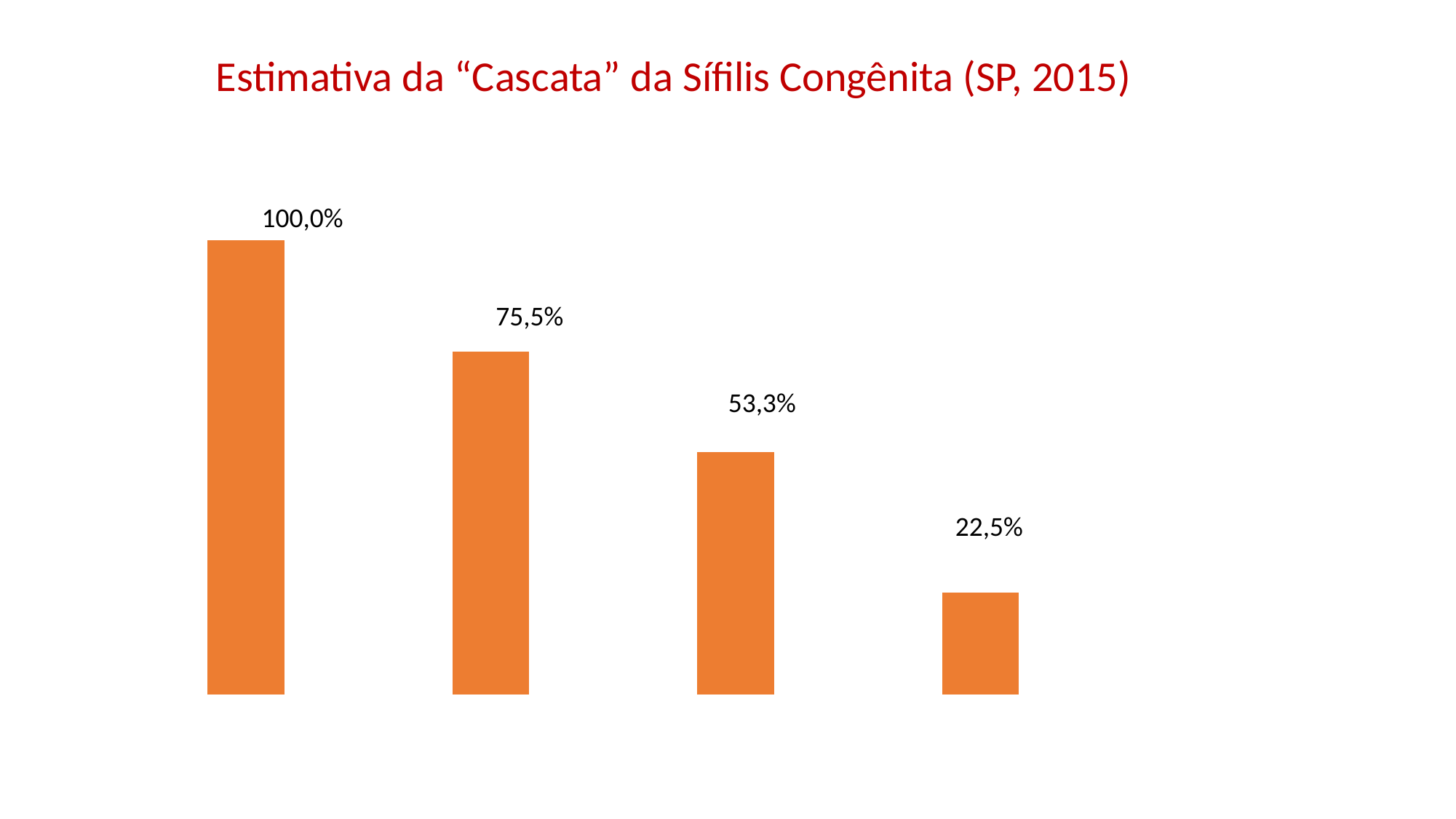
How many bars are plotted in the chart? 4 Which bar has the lowest value? The fourth (rightmost) bar, 22,5% What is the value shown on the first (leftmost) bar? 100,0% What is the value shown on the third bar from the left? 53,3% Do the bar values rise or fall from left to right? Fall What is the value shown on the second bar from the left? 75,5% Which is larger, the second bar or the third bar? The second bar (75,5%) What type of chart is shown on the slide? Bar chart What is the value shown on the fourth (rightmost) bar? 22,5% What is the difference between the first bar (100,0%) and the second bar (75,5%)? 24,5% What is the difference between the third bar (53,3%) and the fourth bar (22,5%)? 30,8% Which bar has the highest value? The first (leftmost) bar, 100,0%